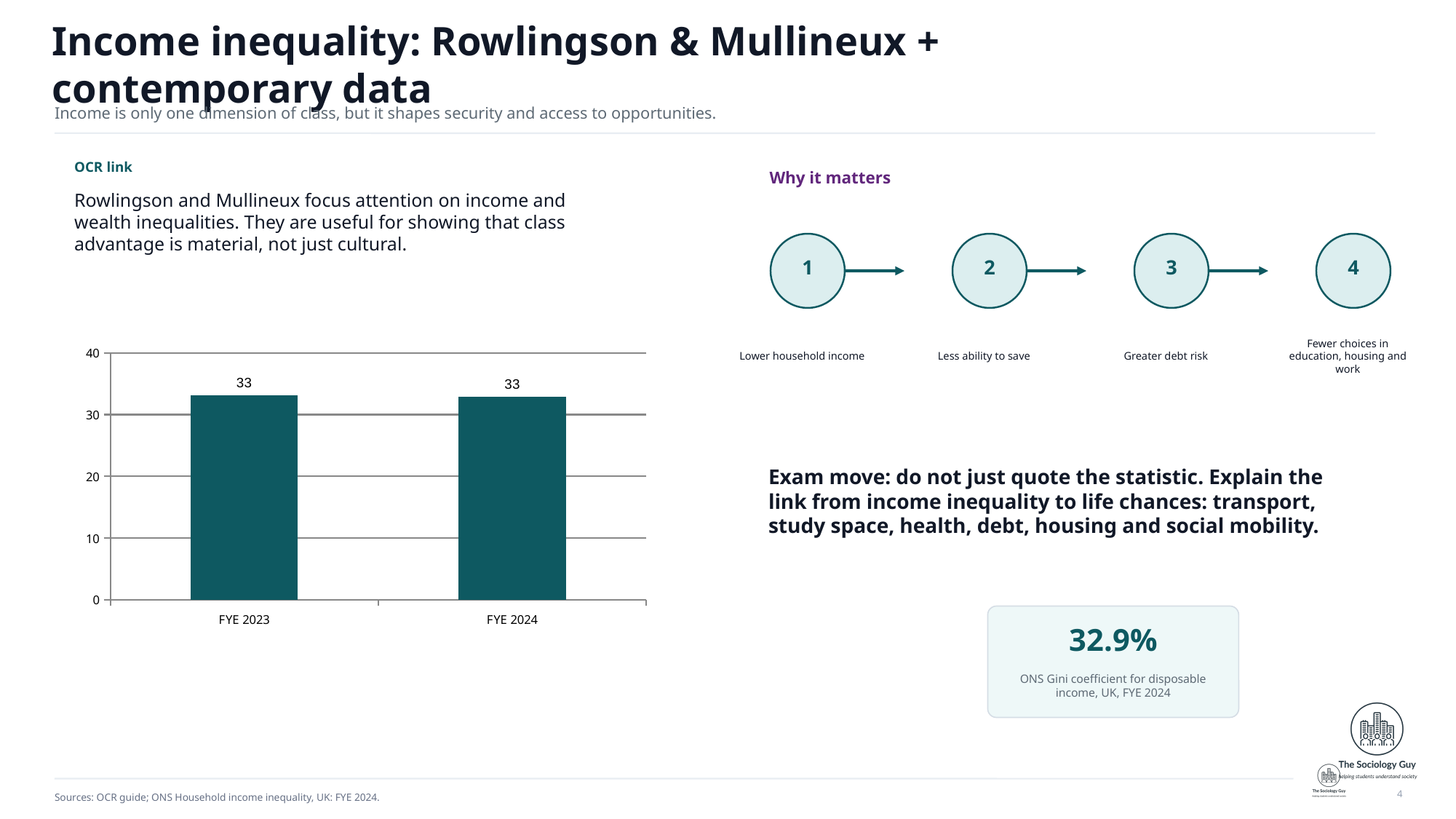
Is the value for FYE 2023 in the bar chart greater or less than 40? less What is the highest tick value shown on the y axis of the bar chart? 40 What is the value for FYE 2023 in the bar chart? 33 How many categories are shown on the x axis of the bar chart? 2 What kind of chart is shown on the slide? bar chart What is the value for FYE 2024 in the bar chart? 33 Is the value for FYE 2024 in the bar chart greater or less than 30? greater What is the label of the first category on the x axis of the bar chart? FYE 2023 What is the difference between the values for FYE 2023 and FYE 2024 in the bar chart? 0 Does the value rise, fall or stay the same from FYE 2023 to FYE 2024 in the bar chart? stays the same